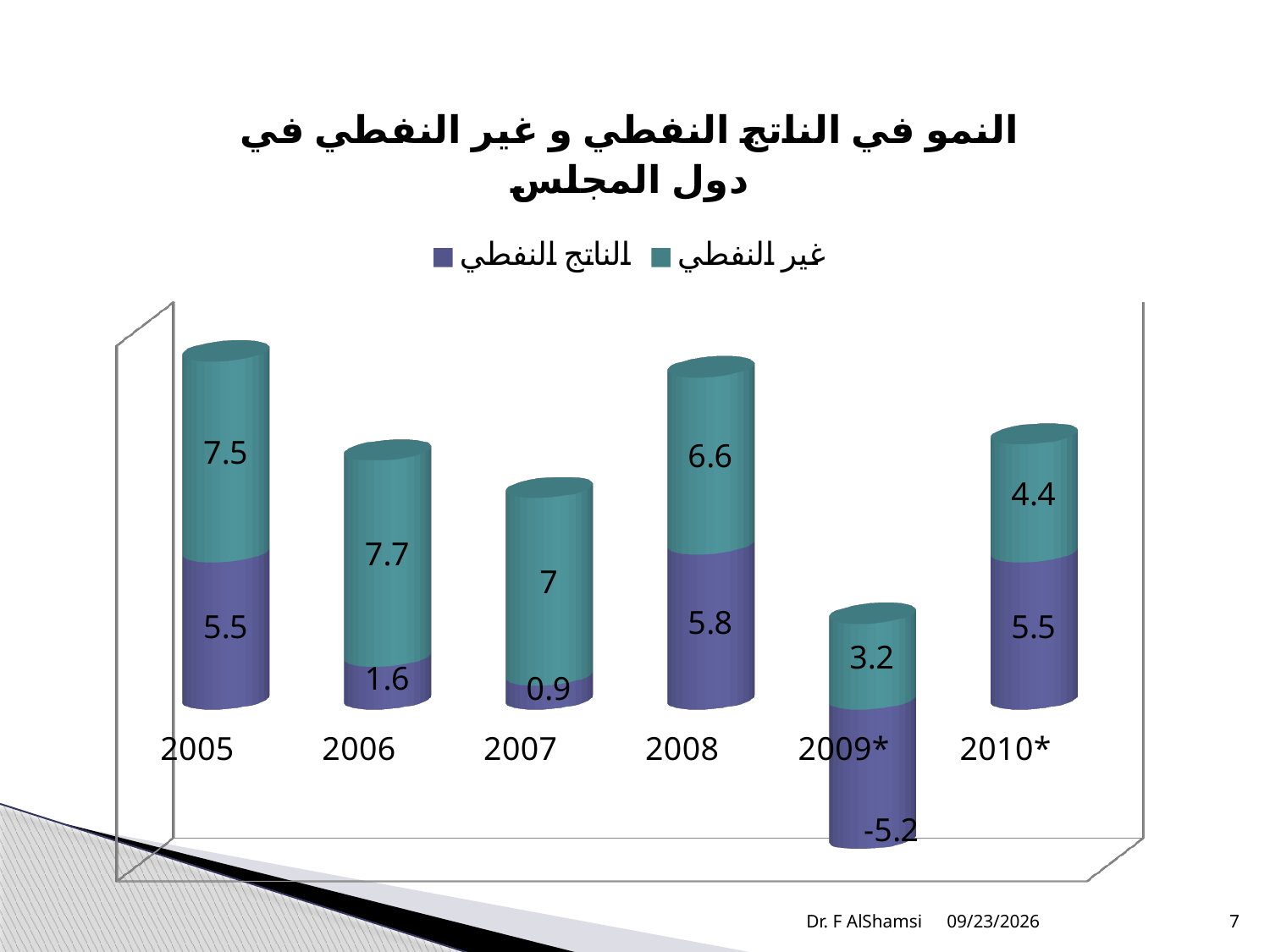
What is the value of the purple (bottom) segment for 2009*? -5.2 Do the teal (top) segment values rise or fall from 2006 to 2009*? Fall What is the total of the stacked bar for 2005? 13 For 2008, what is the difference between the teal segment value and the purple segment value? 0.8 What type of chart is shown on the slide? Stacked bar chart What is the value of the teal (top) segment for 2007? 7 For 2010*, which is larger: the purple (bottom) segment or the teal (top) segment? The purple (bottom) segment Which year has the highest value for the teal (top) segment? 2006 Which year has the lowest value for the purple (bottom) segment? 2009* How many series does the chart's legend list? 2 What is the value of the teal (top) segment for 2006? 7.7 How many years (categories) are shown on the x axis of the chart? 6